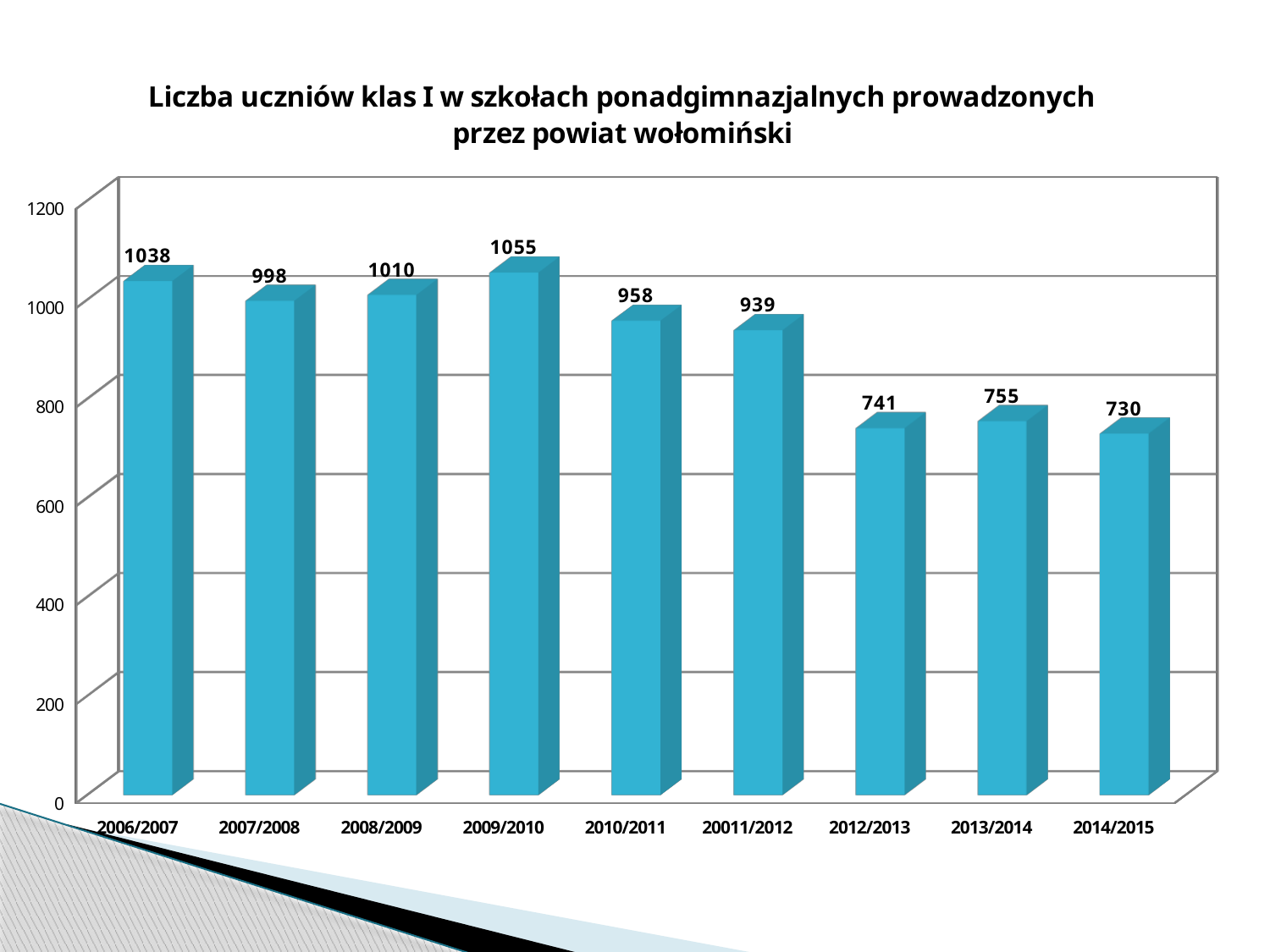
How many school years are shown on the x axis? 9 Which school year has the lowest number of students? 2014/2015 Which is larger, the value for 2007/2008 or the value for 2008/2009? 2008/2009 What is the difference between the values for 2009/2010 and 2014/2015? 325 What is the value shown for 2014/2015? 730 Is the value for 2013/2014 greater or less than 800? less What kind of chart is shown on the slide? bar chart Which school year has the highest number of students? 2009/2010 What is the value shown for 2012/2013? 741 Do the values generally rise or fall from 2006/2007 to 2014/2015? fall What is the number of first-grade students for 2006/2007? 1038 What is the difference between the values for 2010/2011 and 20011/2012? 19